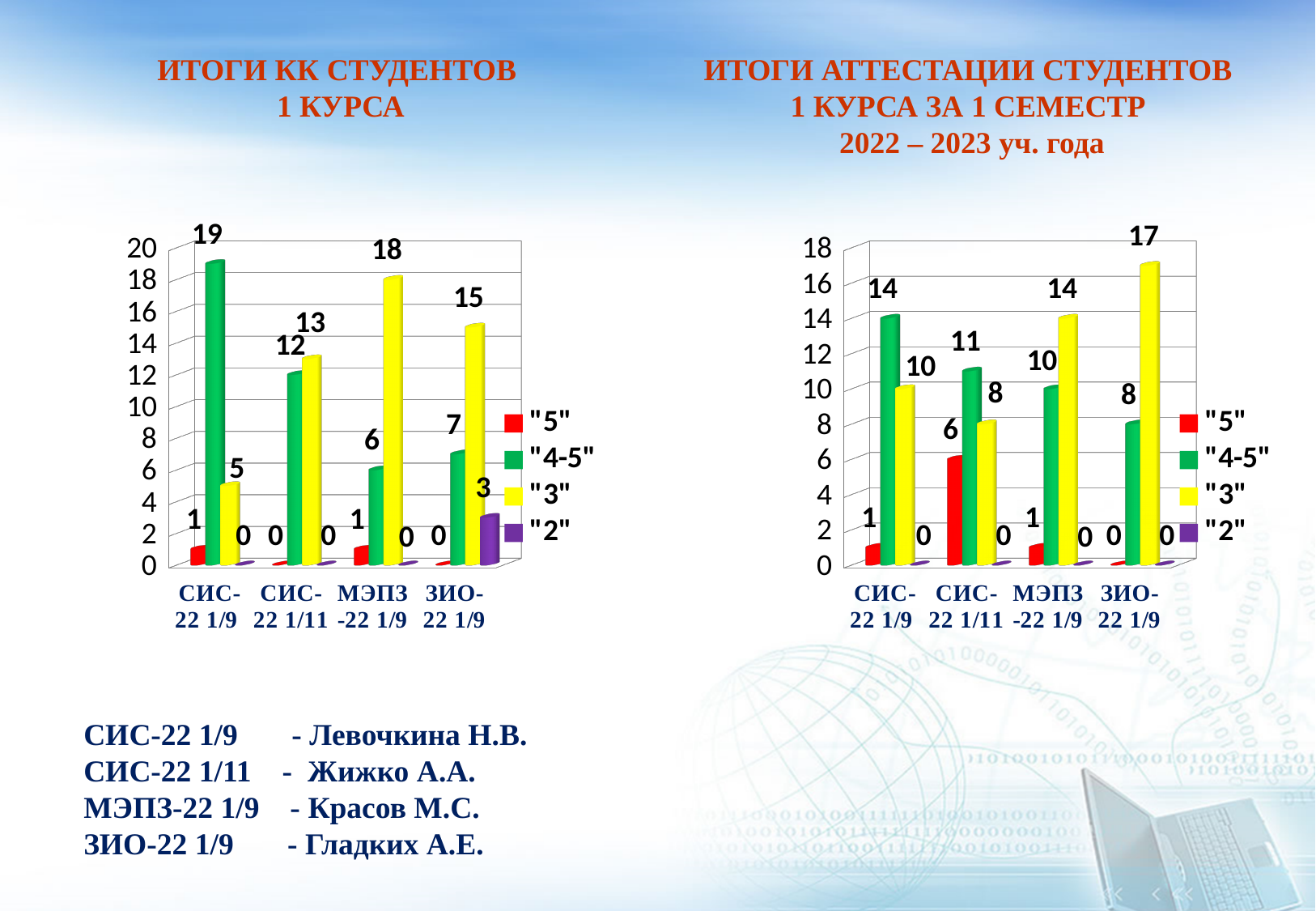
In the right chart (ИТОГИ АТТЕСТАЦИИ СТУДЕНТОВ 1 КУРСА ЗА 1 СЕМЕСТР), which group has the highest value for "4-5"? СИС-22 1/9 In the right chart (ИТОГИ АТТЕСТАЦИИ СТУДЕНТОВ 1 КУРСА ЗА 1 СЕМЕСТР), what is the difference between the "4-5" and "3" values for СИС-22 1/11? 3 In the left chart (ИТОГИ КК СТУДЕНТОВ 1 КУРСА), how many series does the legend list? 4 How many groups (categories) are shown on the x axis of the right chart (ИТОГИ АТТЕСТАЦИИ СТУДЕНТОВ 1 КУРСА ЗА 1 СЕМЕСТР)? 4 In the left chart (ИТОГИ КК СТУДЕНТОВ 1 КУРСА), what is the value of "4-5" for СИС-22 1/9? 19 What type of chart is the left chart (ИТОГИ КК СТУДЕНТОВ 1 КУРСА)? Bar chart In the right chart (ИТОГИ АТТЕСТАЦИИ СТУДЕНТОВ 1 КУРСА ЗА 1 СЕМЕСТР), what is the value of "3" for ЗИО-22 1/9? 17 In the left chart (ИТОГИ КК СТУДЕНТОВ 1 КУРСА), which group has the highest value for "3"? МЭПЗ-22 1/9 In the right chart (ИТОГИ АТТЕСТАЦИИ СТУДЕНТОВ 1 КУРСА ЗА 1 СЕМЕСТР), what is the value of "5" for СИС-22 1/11? 6 In the left chart (ИТОГИ КК СТУДЕНТОВ 1 КУРСА), what is the difference between the "3" and "4-5" values for ЗИО-22 1/9? 8 In the right chart (ИТОГИ АТТЕСТАЦИИ СТУДЕНТОВ 1 КУРСА ЗА 1 СЕМЕСТР), which is larger for МЭПЗ-22 1/9: the "4-5" value or the "3" value? "3" In the left chart (ИТОГИ КК СТУДЕНТОВ 1 КУРСА), what is the value of "3" for МЭПЗ-22 1/9? 18